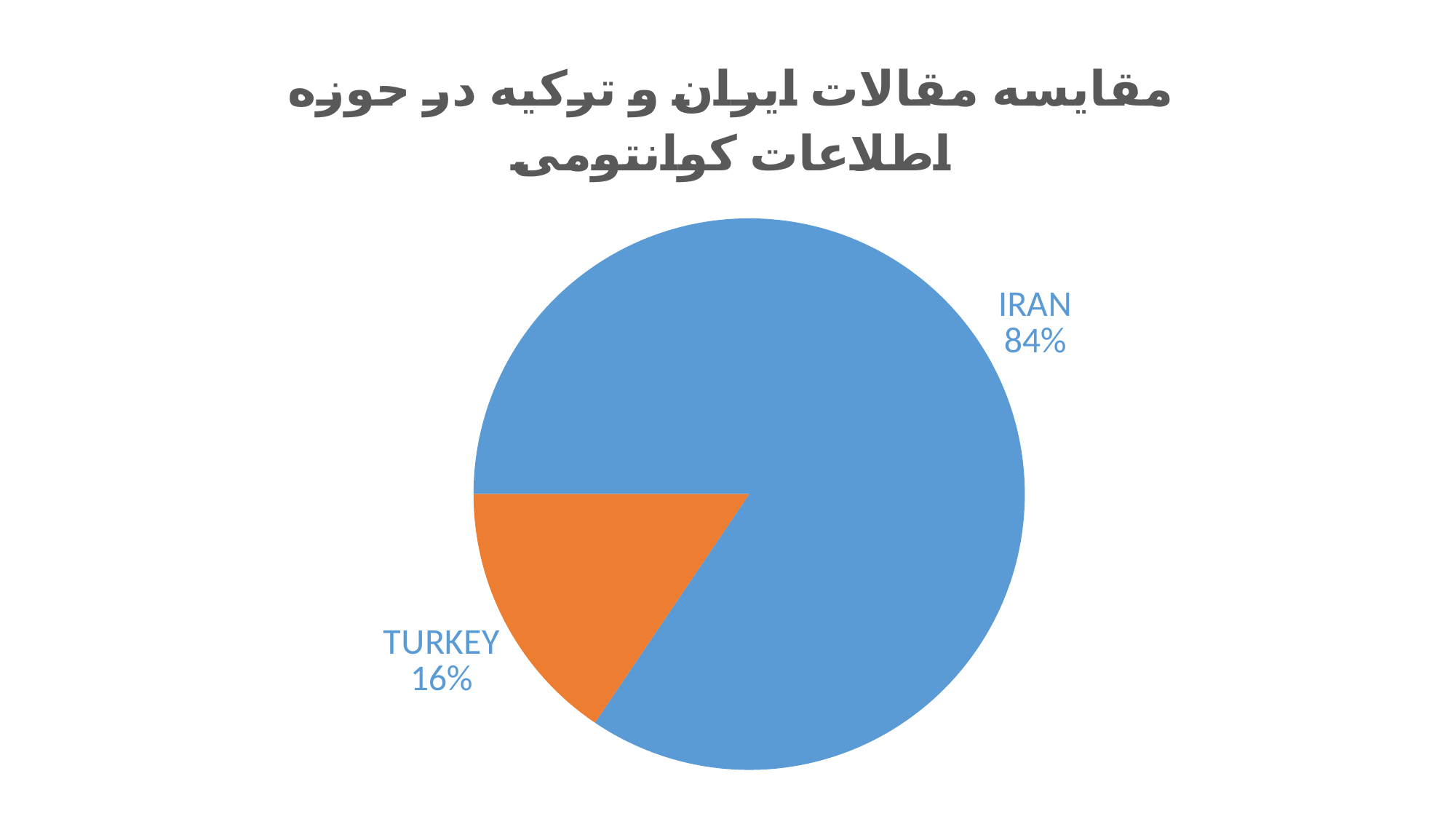
What colour is the TURKEY slice? orange Which slice of the pie is the smallest? TURKEY What is the difference in percentage points between the IRAN and TURKEY slices? 68 What kind of chart is shown on the slide? pie chart What share of the pie does IRAN have? 84% What colour is the IRAN slice? blue Which slice of the pie is the largest? IRAN What share of the pie does TURKEY have? 16% Which is larger, the IRAN slice or the TURKEY slice? IRAN How many slices does the pie chart have? 2